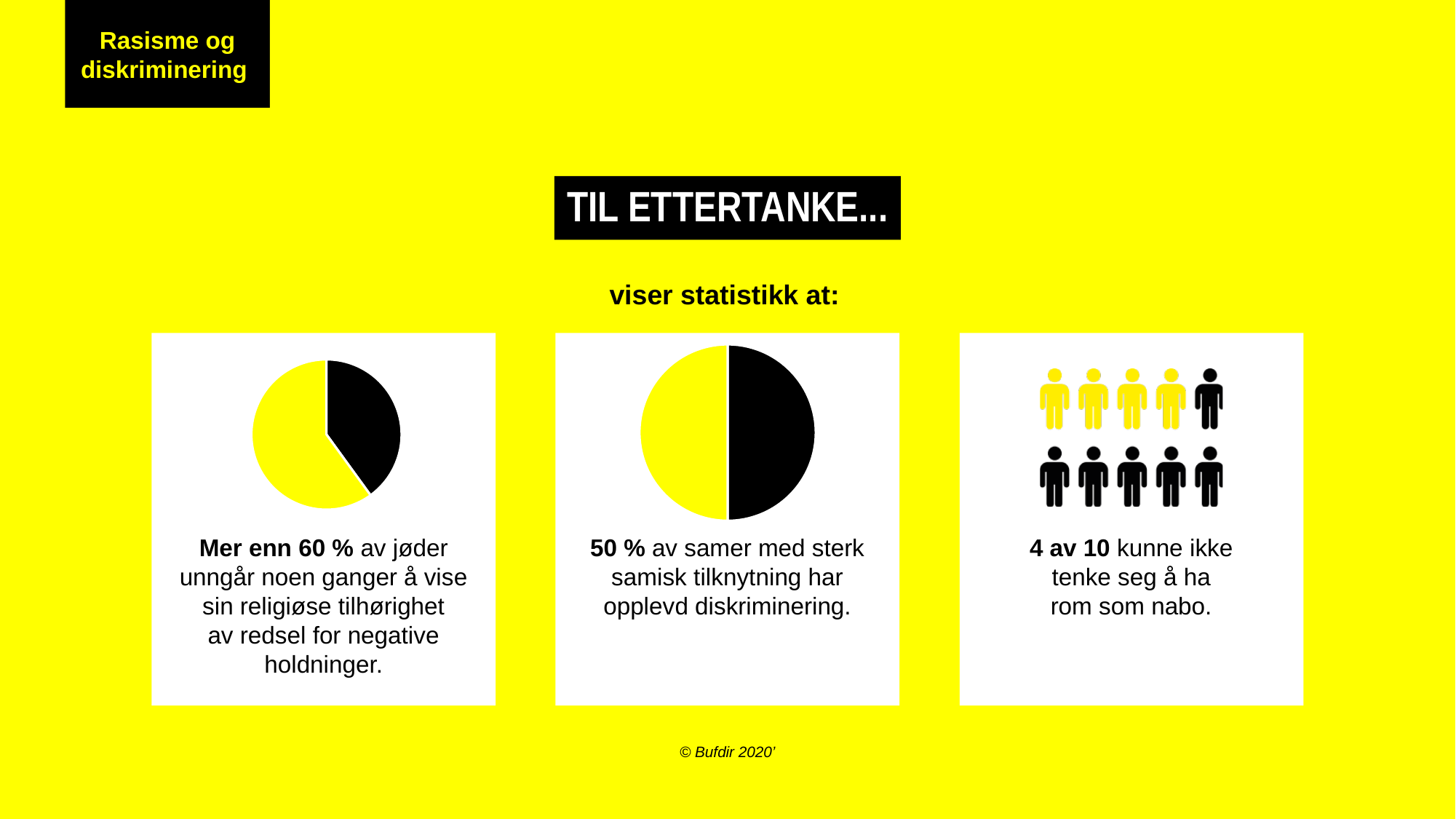
In the left pie chart, which slice is larger, the yellow one or the black one? yellow What is the heading in the black box above the three charts? TIL ETTERTANKE... In the middle pie chart, what share of Sami with strong Sami affiliation have experienced discrimination? 50 % According to the right panel, how many out of 10 could not imagine having Roma as neighbours? 4 av 10 In the right panel pictogram, how many of the person figures are black? 6 According to the text under the left pie chart, what share of Jews sometimes avoid showing their religious affiliation? Mer enn 60 % What kind of chart is shown in the middle panel about Sami (samer)? pie chart In the right panel pictogram, how many of the person figures are yellow? 4 How many slices does the middle pie chart have? 2 What kind of chart is shown in the left panel about Jews (jøder)? pie chart In the left pie chart, is the yellow slice greater or less than 50%? greater